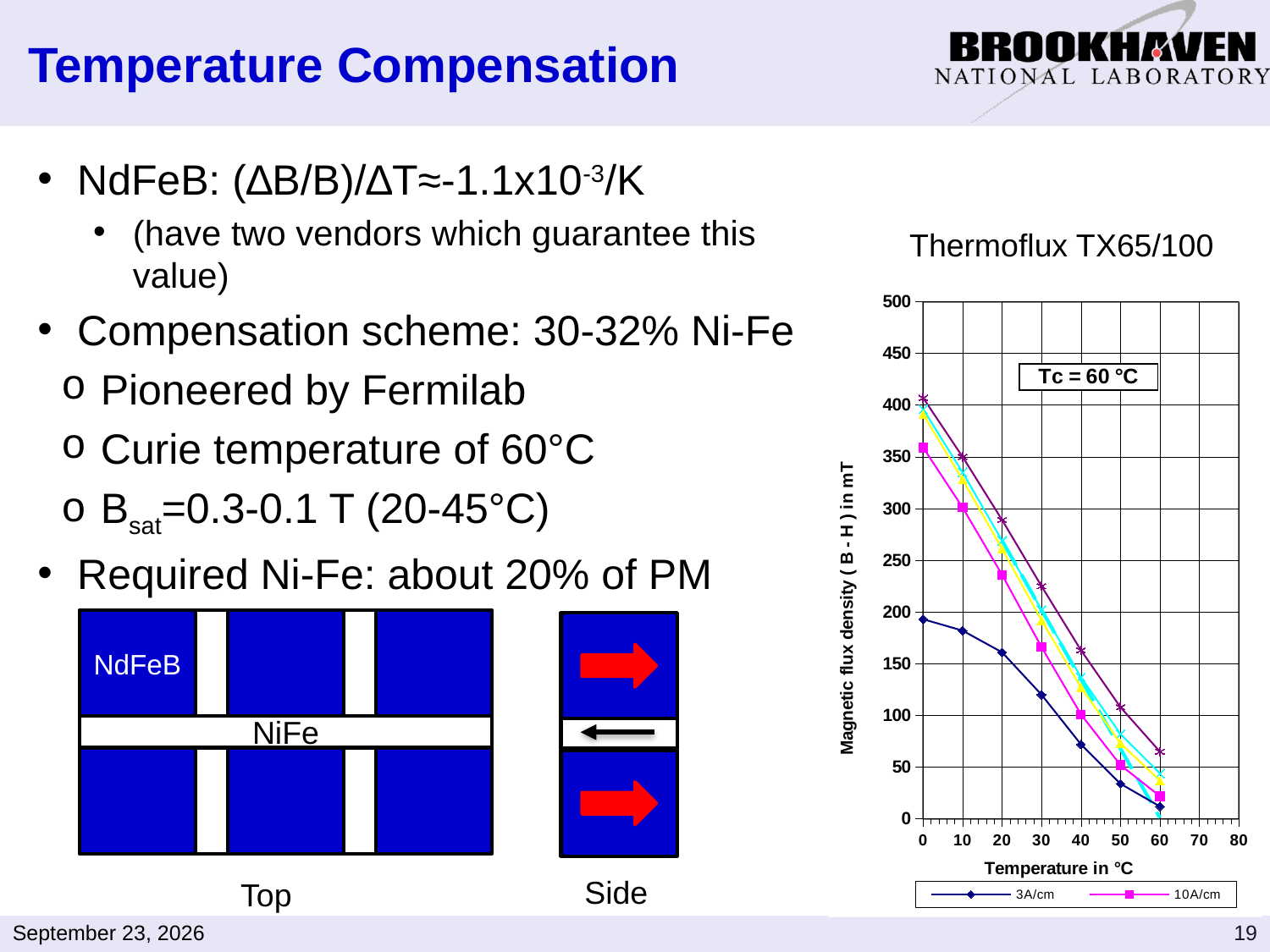
What Curie temperature is annotated inside the Thermoflux TX65/100 chart? Tc = 60 °C What is the x-axis label of the Thermoflux TX65/100 chart? Temperature in °C In the Thermoflux TX65/100 chart, is the value for the 10A/cm series at 30 °C greater or less than 150? greater What kind of chart is the Thermoflux TX65/100 chart? line chart In the Thermoflux TX65/100 chart, is the value for the 3A/cm series at 0 °C greater or less than 200? less In the Thermoflux TX65/100 chart, do the values rise or fall as temperature increases along the x axis? fall How many series does the legend of the Thermoflux TX65/100 chart list? 2 In the Thermoflux TX65/100 chart, is the value for the 10A/cm series at 0 °C greater or less than 300? greater In the Thermoflux TX65/100 chart, which series has the larger value at 0 °C, 3A/cm or 10A/cm? 10A/cm